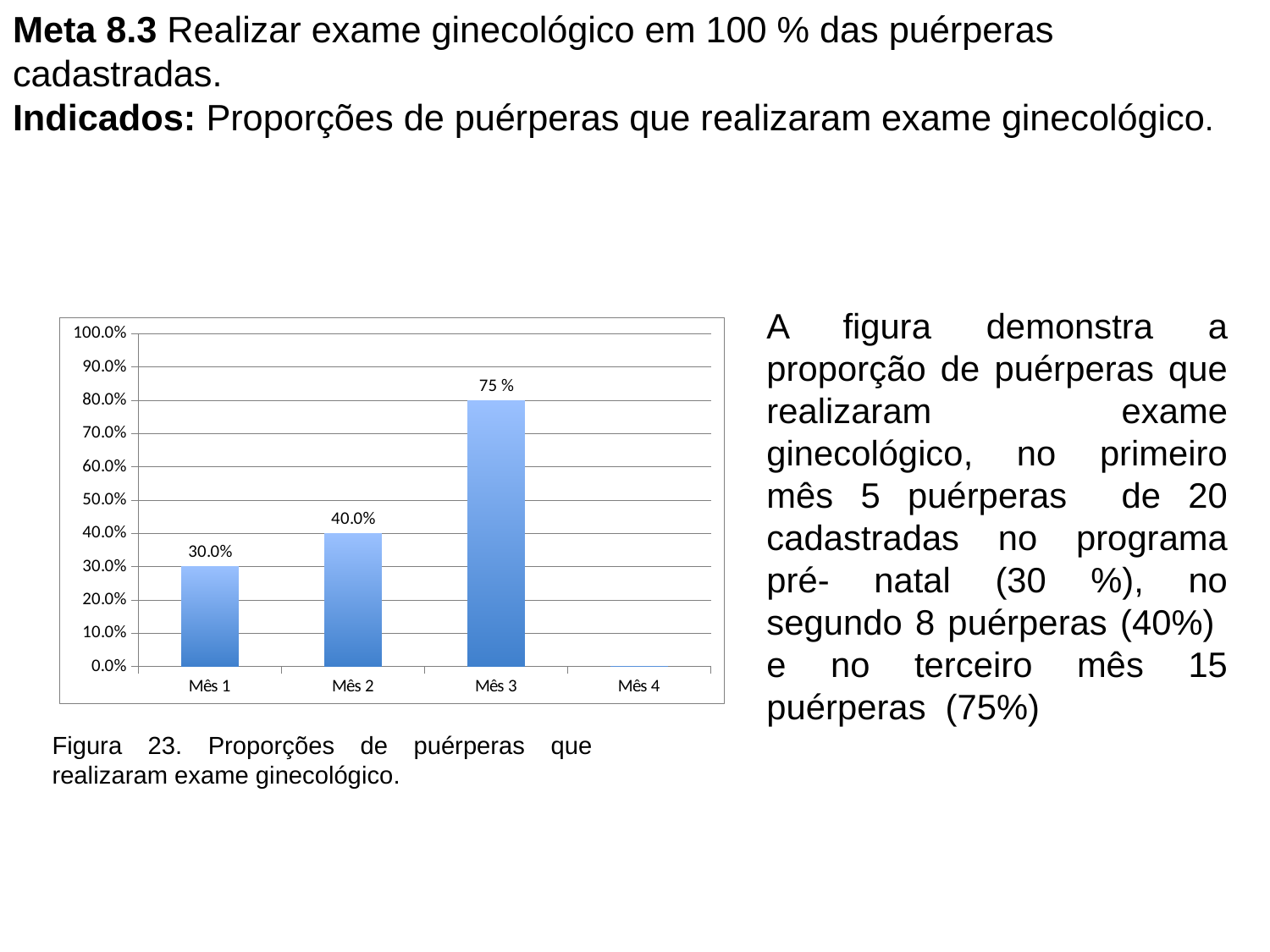
What data label is shown above the bar for Mês 3? 75 % How many bars are plotted in the chart? 3 Which is larger, the value for Mês 2 or the value for Mês 1? Mês 2 Which month has the highest bar? Mês 3 Is the value for Mês 3 greater or less than 60.0%? greater What kind of chart is shown? bar chart What is the difference between the values for Mês 2 and Mês 1? 10.0% What is the value shown for Mês 2? 40.0% Do the values rise or fall from Mês 1 to Mês 3? rise What is the value shown for Mês 1? 30.0% How many categories are labelled on the x axis? 4 Among the months with a plotted bar, which has the lowest value? Mês 1